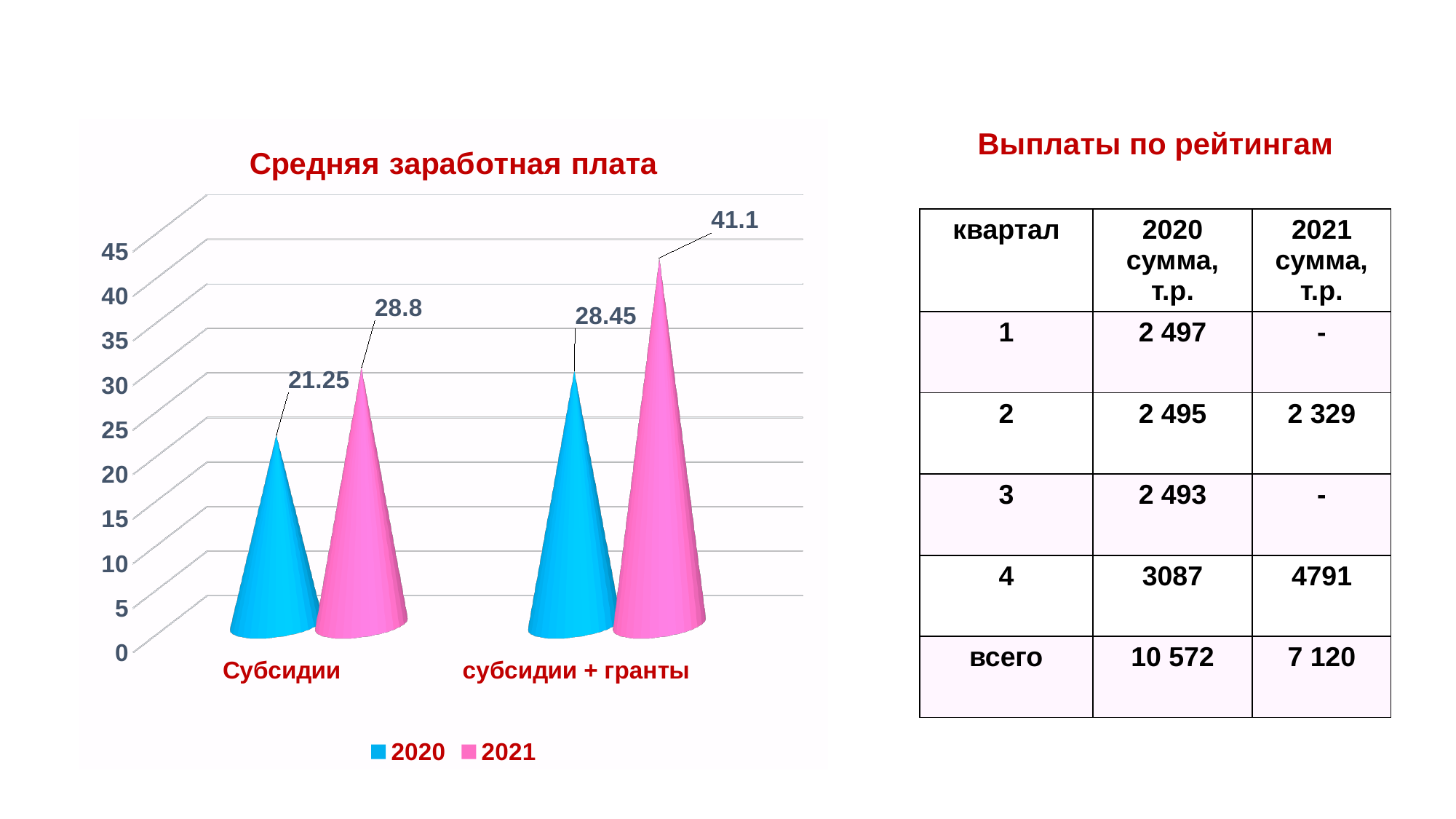
What is the title of the chart? Средняя заработная плата Which category and series has the lowest value on the chart? Субсидии, 2020 Which category and series has the highest value on the chart? субсидии + гранты, 2021 What is the difference between the 2021 and 2020 values in the "субсидии + гранты" category? 12.65 What is the value for 2021 in the "Субсидии" category? 28.8 What is the value for 2020 in the "Субсидии" category? 21.25 How many categories are shown on the x axis of the chart? 2 What is the difference between the 2021 and 2020 values in the "Субсидии" category? 7.55 What is the value for 2020 in the "субсидии + гранты" category? 28.45 Which is larger: the 2021 value for "Субсидии" or the 2020 value for "субсидии + гранты"? 2021 value for Субсидии How many series does the chart legend list? 2 What is the value for 2021 in the "субсидии + гранты" category? 41.1